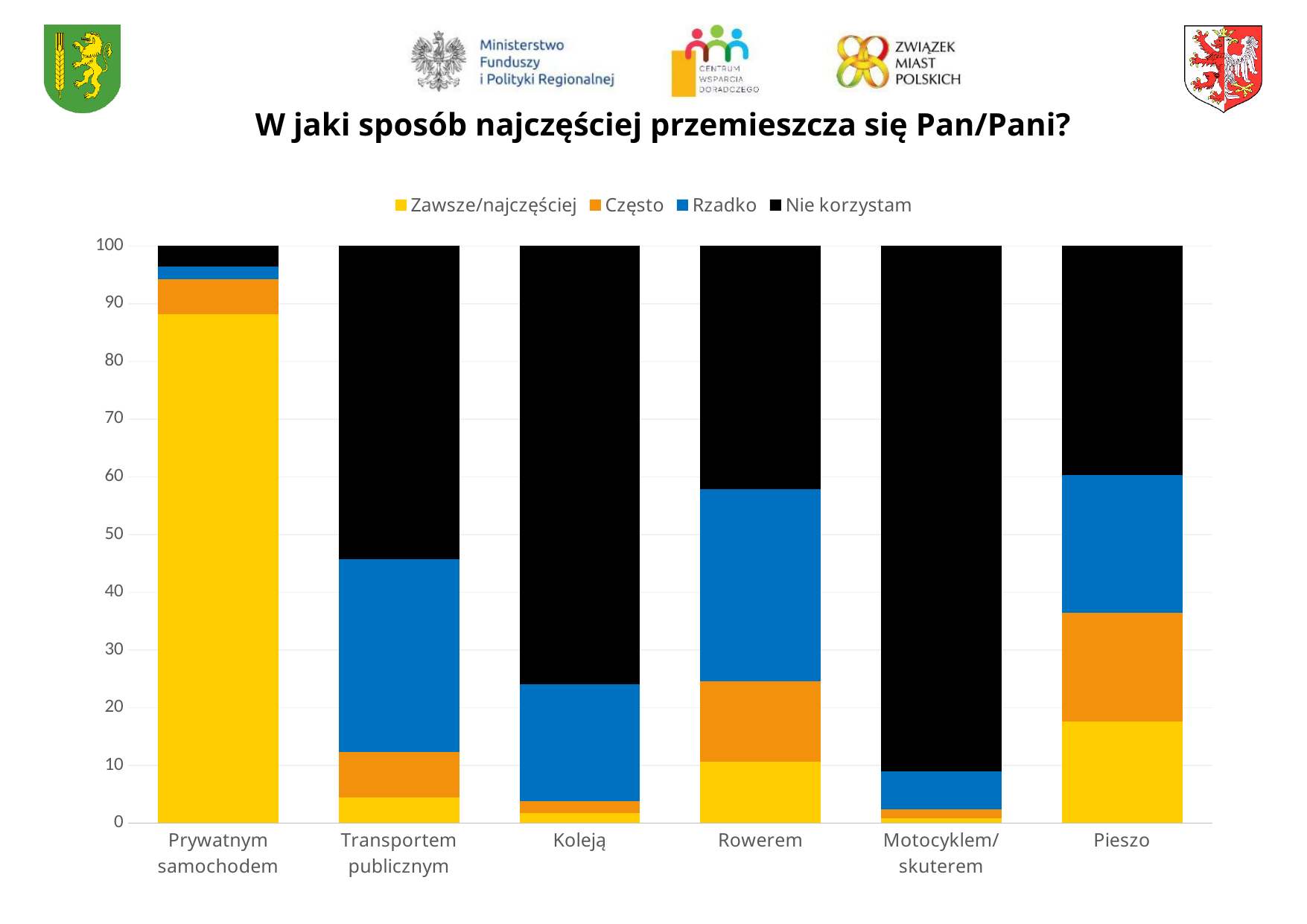
Which category has the highest value for the 'Nie korzystam' series? Motocyklem/skuterem Is the 'Zawsze/najczęściej' value for Koleją greater or less than 10? less Which category has the highest value for the 'Zawsze/najczęściej' series? Prywatnym samochodem What kind of chart is shown on the slide? stacked bar chart Which is larger: the 'Zawsze/najczęściej' value for Pieszo or for Rowerem? Pieszo Is the 'Nie korzystam' value for Motocyklem/skuterem greater or less than 80? greater Which colour represents the 'Rzadko' series in the legend? blue How many series does the legend list? 4 Which category has the lowest value for the 'Nie korzystam' series? Prywatnym samochodem How many categories (modes of transport) are shown on the x axis? 6 Which category has the highest value for the 'Często' series? Pieszo Is the 'Zawsze/najczęściej' value for Prywatnym samochodem greater or less than 80? greater